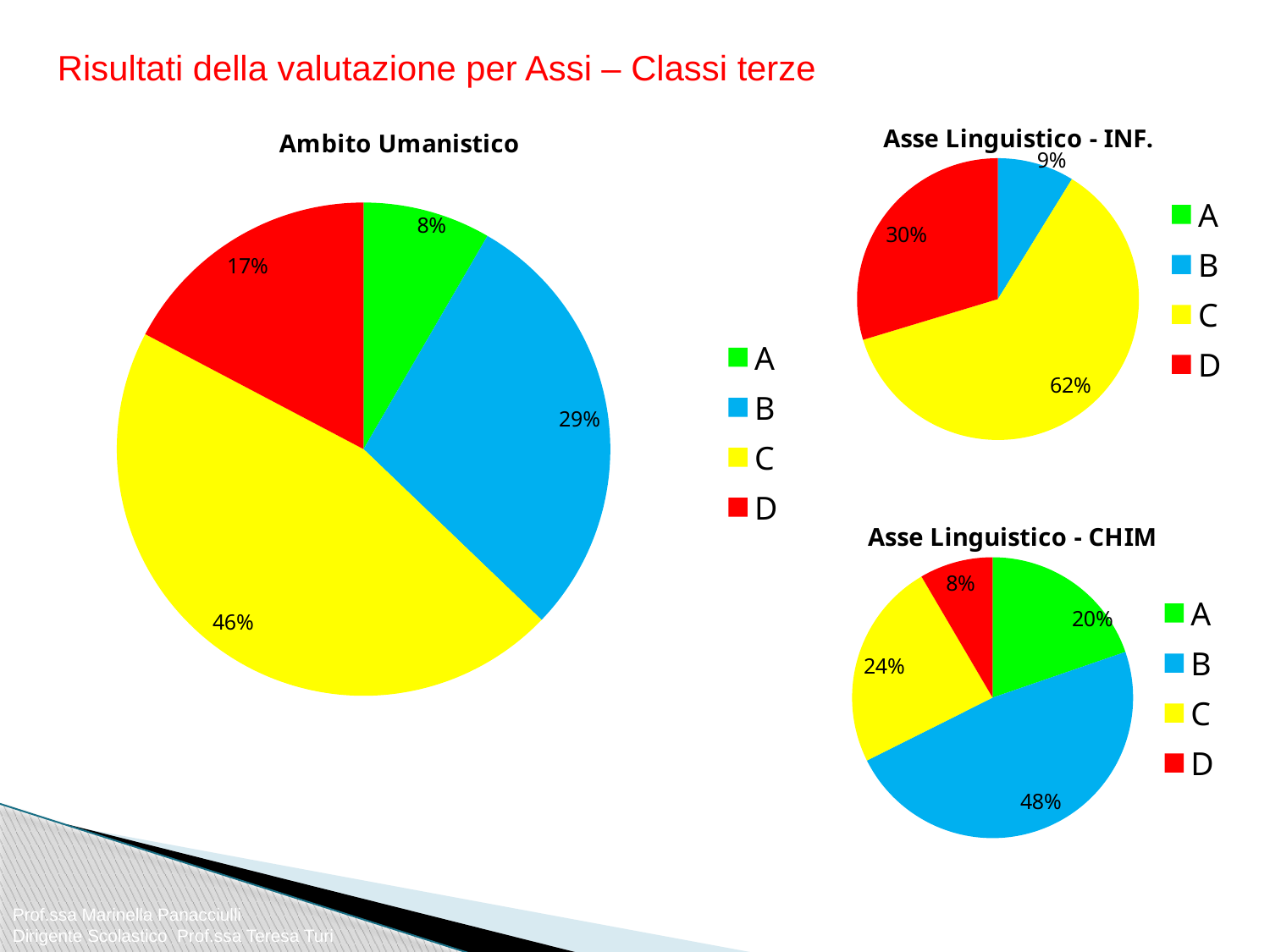
In the Asse Linguistico - INF. chart, which category has the largest share? C In the Ambito Umanistico chart, what colour is the slice for category D? Red In the Ambito Umanistico chart, which category has the smallest share? A In the Asse Linguistico - CHIM chart, which category has the smallest share? D In the Asse Linguistico - CHIM chart, what percentage is shown for category B? 48% In the Asse Linguistico - INF. chart, what is the difference between the shares of C and D? 32% What type of chart is the Ambito Umanistico chart? Pie chart How many entries does the legend of the Asse Linguistico - CHIM chart list? 4 In the Asse Linguistico - INF. chart, what percentage is shown for category D? 30% In the Ambito Umanistico chart, what is the difference between the shares of B and D? 12% In the Asse Linguistico - CHIM chart, which is larger, the share of A or the share of C? C In the Ambito Umanistico chart, what percentage is shown for category C? 46%